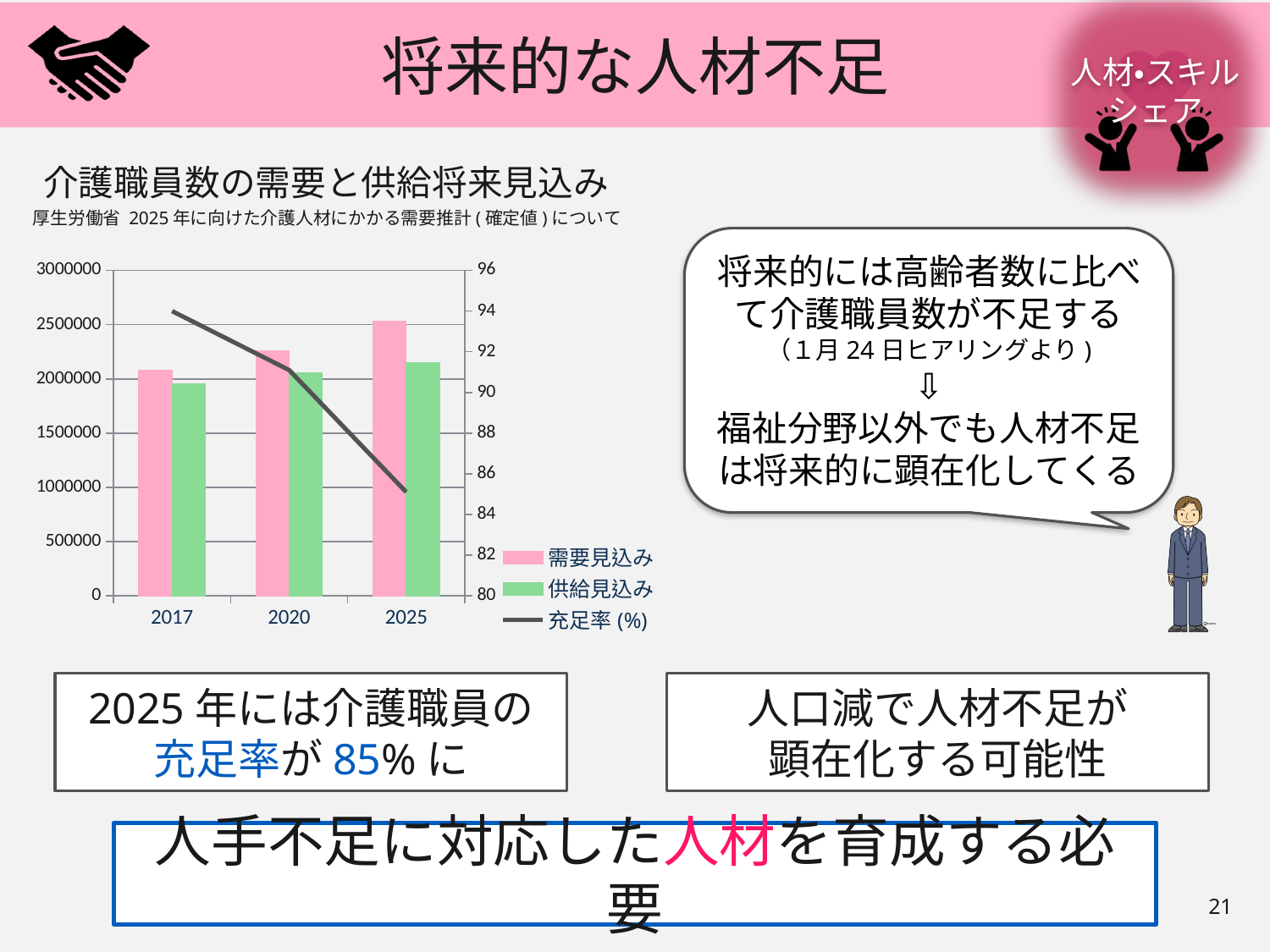
In which year is the 供給見込み bar the lowest? 2017 Is the 供給見込み value for 2017 greater or less than 2000000? less Is the 需要見込み value for 2017 greater or less than 2000000? greater How many series does the chart legend list? 3 What kind of chart is shown on the slide? bar chart with a line Do the 需要見込み bars rise or fall from 2017 to 2025? rise In which year is the 需要見込み bar the highest? 2025 In 2025, which is larger, 需要見込み or 供給見込み? 需要見込み How many years are shown on the x axis of the chart? 3 What is the title of the chart? 介護職員数の需要と供給将来見込み Does the 充足率 (%) line rise or fall from 2017 to 2025? fall Is the 充足率 (%) value for 2017 greater or less than 92? greater